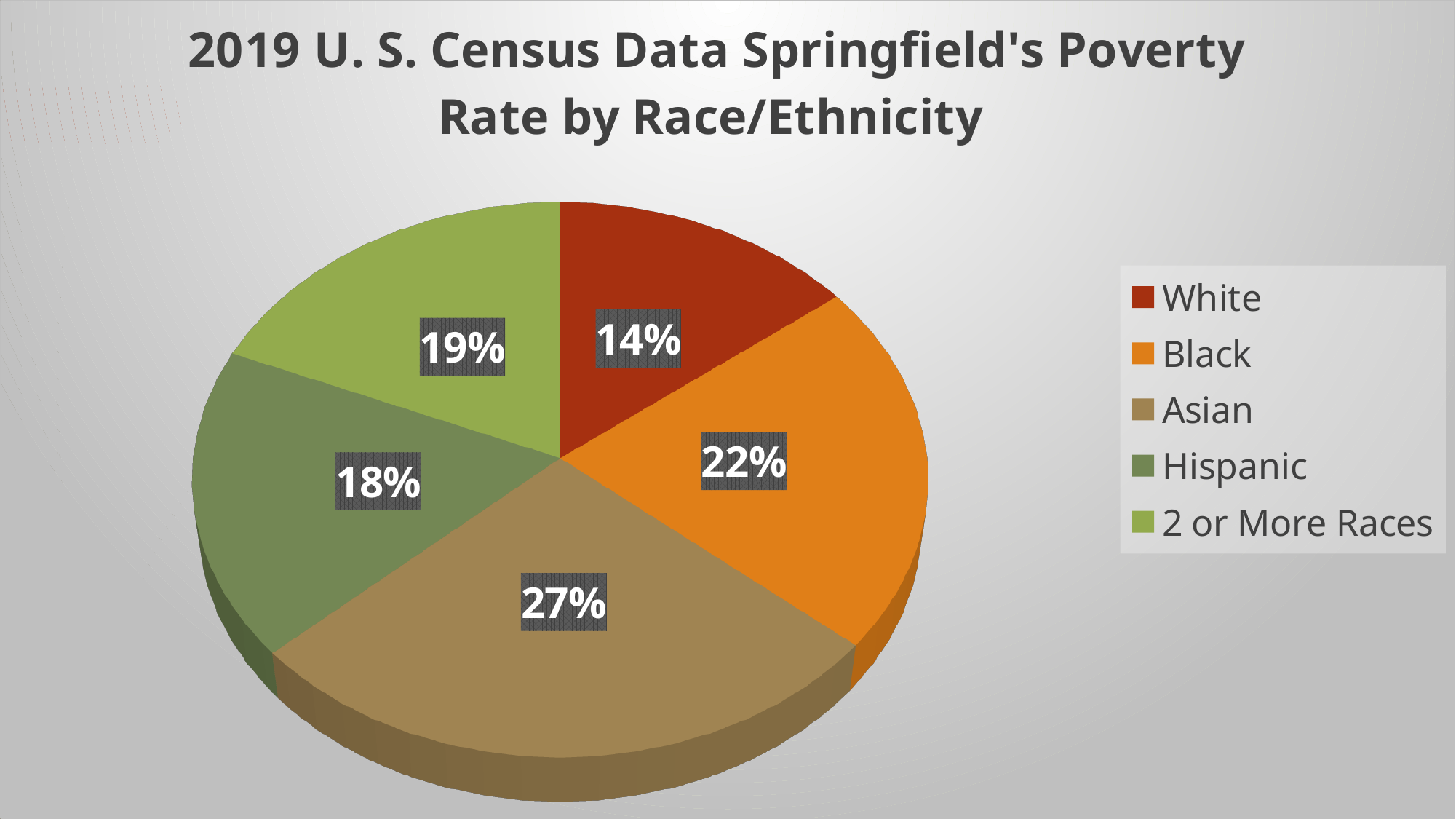
What is the poverty rate shown for Asian? 27% What is the poverty rate shown for Hispanic? 18% What is the difference between the poverty rates for Asian and White? 13% What is the poverty rate shown for Black? 22% What kind of chart is shown on the slide? Pie chart How many race/ethnicity categories are shown in the pie chart? 5 What is the poverty rate shown for White? 14% What is the title of the chart? 2019 U. S. Census Data Springfield's Poverty Rate by Race/Ethnicity What is the poverty rate shown for 2 or More Races? 19% Which race/ethnicity has the lowest poverty rate on the chart? White Which race/ethnicity has the highest poverty rate on the chart? Asian Which has a higher poverty rate, Black or Hispanic? Black